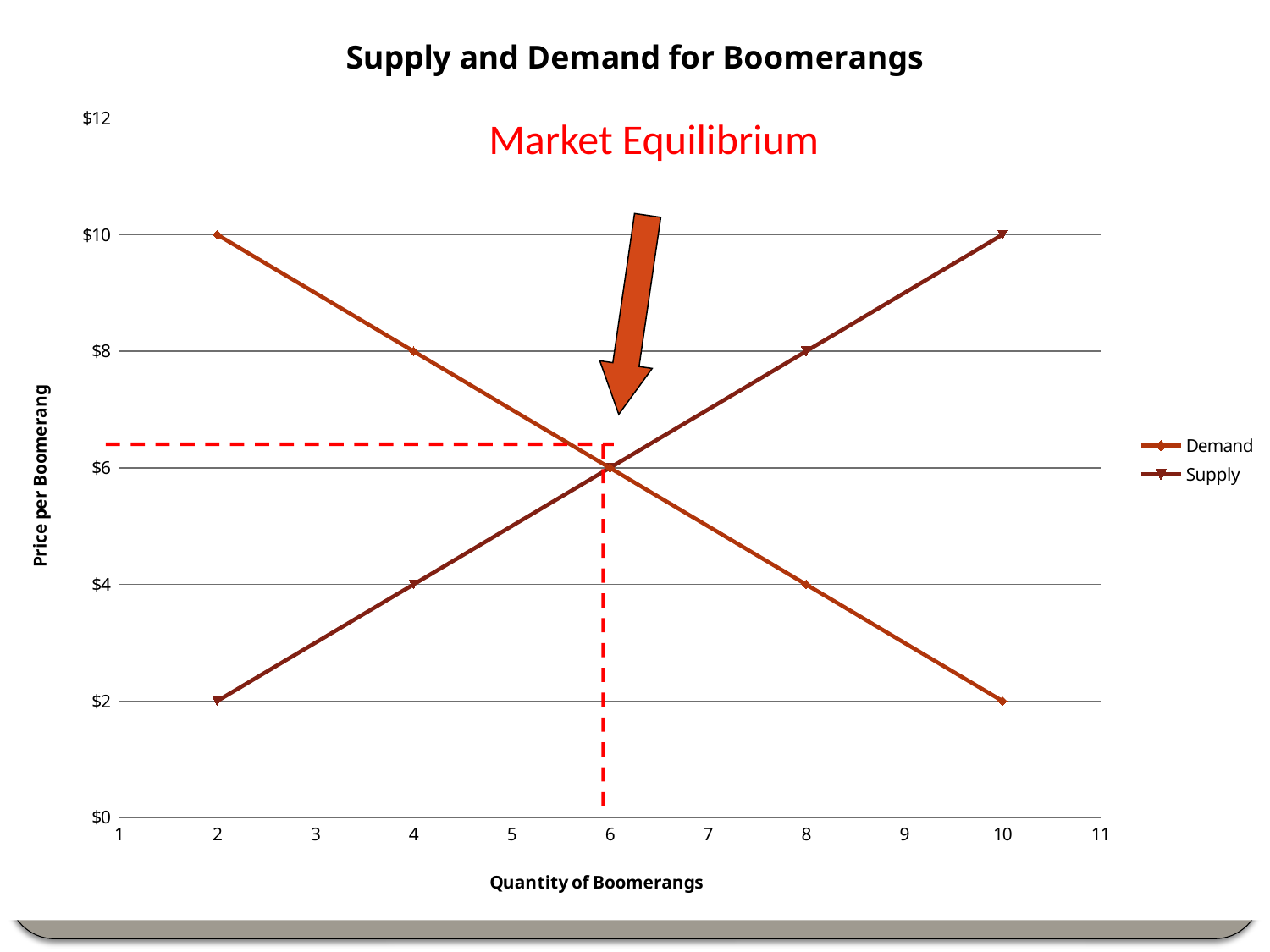
What kind of chart is shown on the slide? line chart Does the Demand line rise or fall as quantity increases? fall What is the title of the chart? Supply and Demand for Boomerangs At what quantity of boomerangs do the Demand and Supply lines intersect? 6 At a quantity of 8, which is higher, the Demand price or the Supply price? Supply How many data points are plotted on the Demand line? 5 What is the price per boomerang on the Supply line at a quantity of 10? $10 What is the price per boomerang on the Demand line at a quantity of 2? $10 What is the difference between the Demand price and the Supply price at a quantity of 2? $8 Does the Supply line rise or fall as quantity increases? rise How many series does the legend list? 2 At what price do the Demand and Supply lines intersect? $6